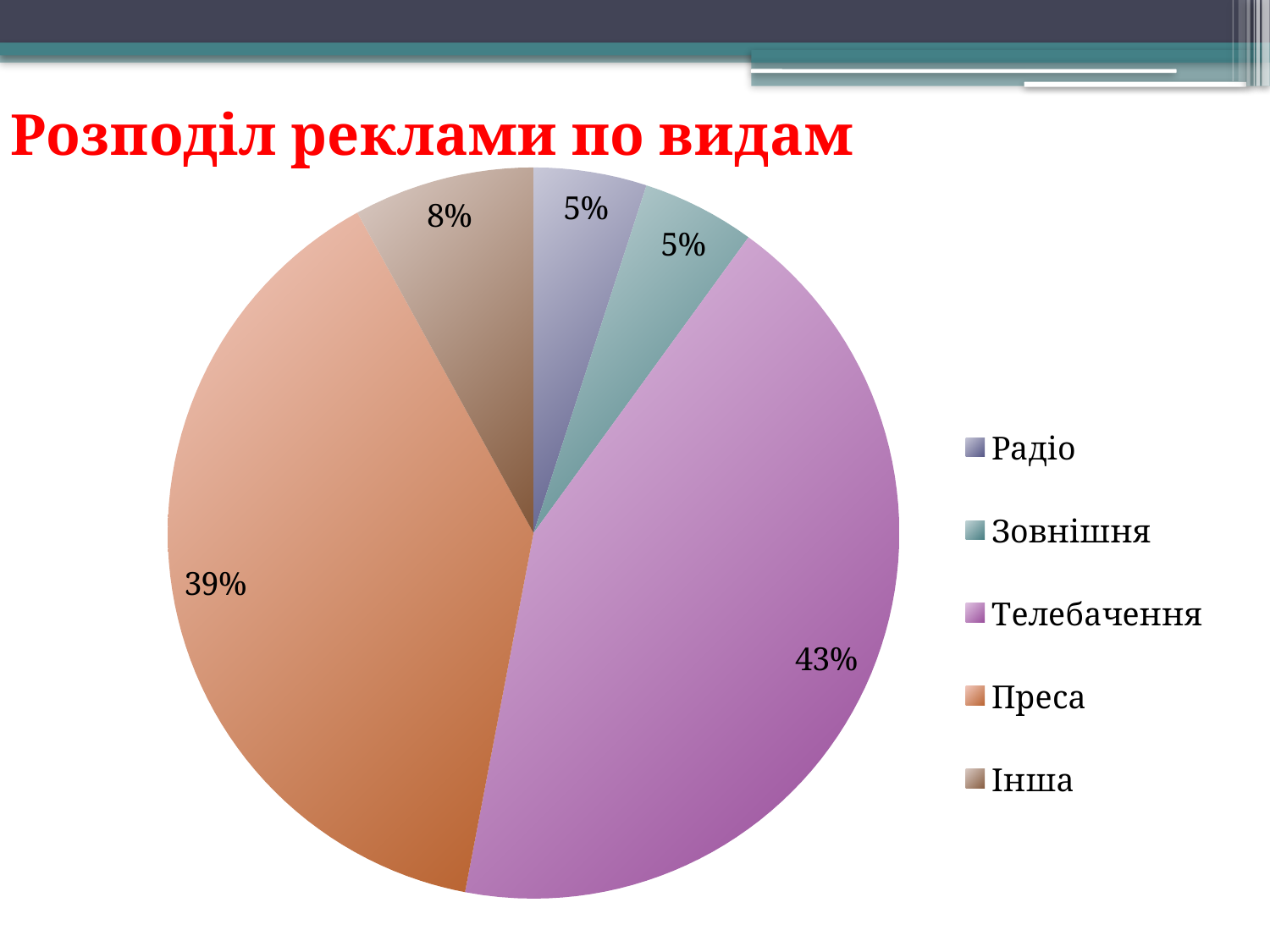
Which category has the largest slice of the pie? Телебачення Which two categories share the smallest slice of the pie? Радіо and Зовнішня How many categories does the pie chart show? 5 What percentage does the Радіо slice show? 5% What colour is the Телебачення slice? Purple What is the difference in percentage points between Телебачення and Преса? 4 What percentage is shown for Преса? 39% What is the value of the Інша slice? 8% What is the title of the chart? Розподіл реклами по видам Which is larger, the Преса slice or the Інша slice? Преса What share of the pie does Телебачення have? 43% What type of chart is shown on the slide? Pie chart